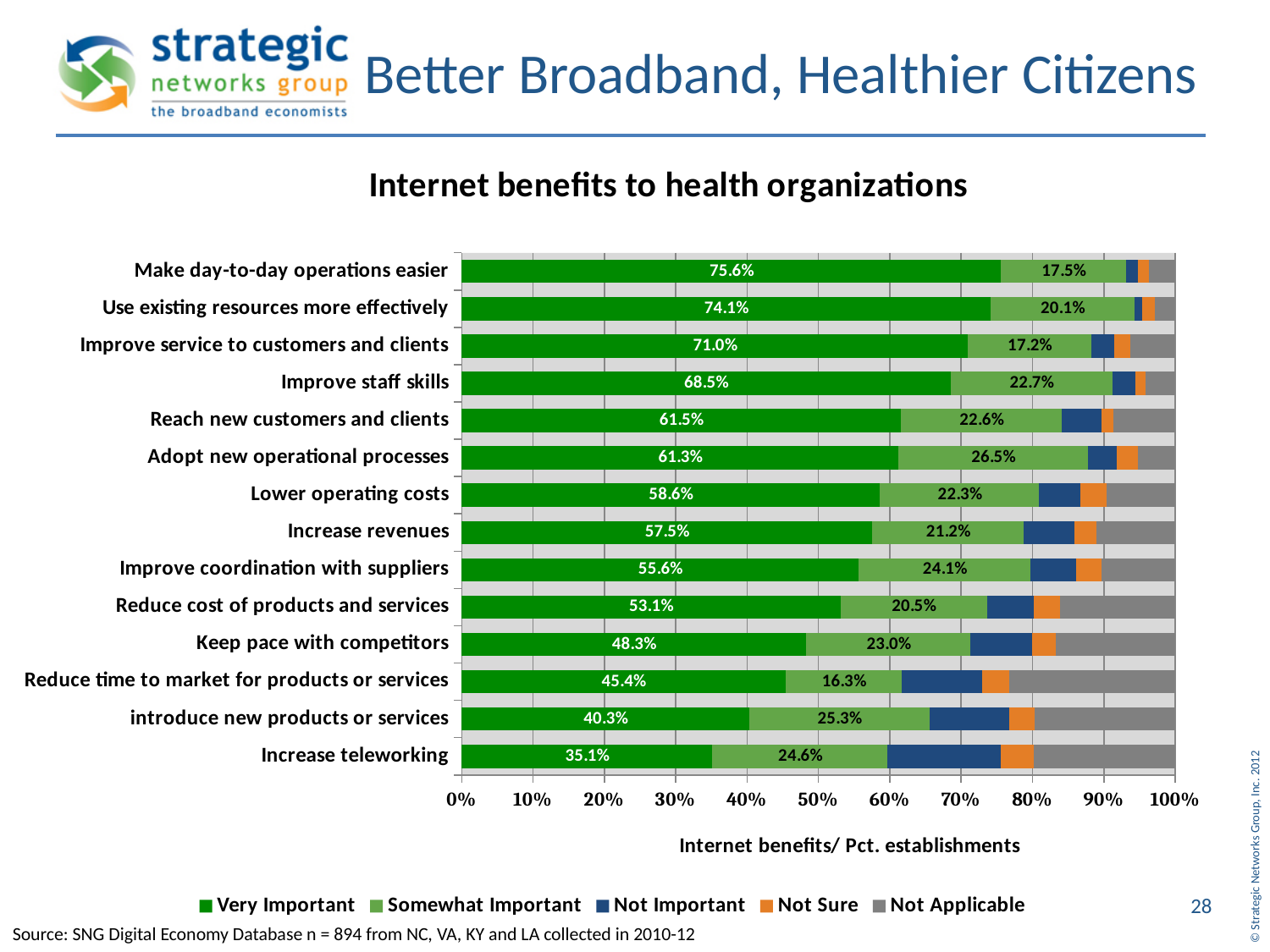
What is the Somewhat Important value for 'Improve staff skills'? 22.7% How many benefit categories are listed on the chart? 14 What percentage of establishments rated 'Make day-to-day operations easier' as Very Important? 75.6% What is the title of the chart? Internet benefits to health organizations What is the Very Important value for 'Increase teleworking'? 35.1% How many series does the legend list? 5 Which benefit has the highest Somewhat Important percentage? Adopt new operational processes What type of chart is shown on the slide? Stacked bar chart Which benefit has the highest Very Important percentage? Make day-to-day operations easier What is the difference between the Very Important values for 'Improve service to customers and clients' and 'Keep pace with competitors'? 22.7% Which benefit has the lowest Very Important percentage? Increase teleworking Which has a larger Very Important value: 'Lower operating costs' or 'Increase revenues'? Lower operating costs